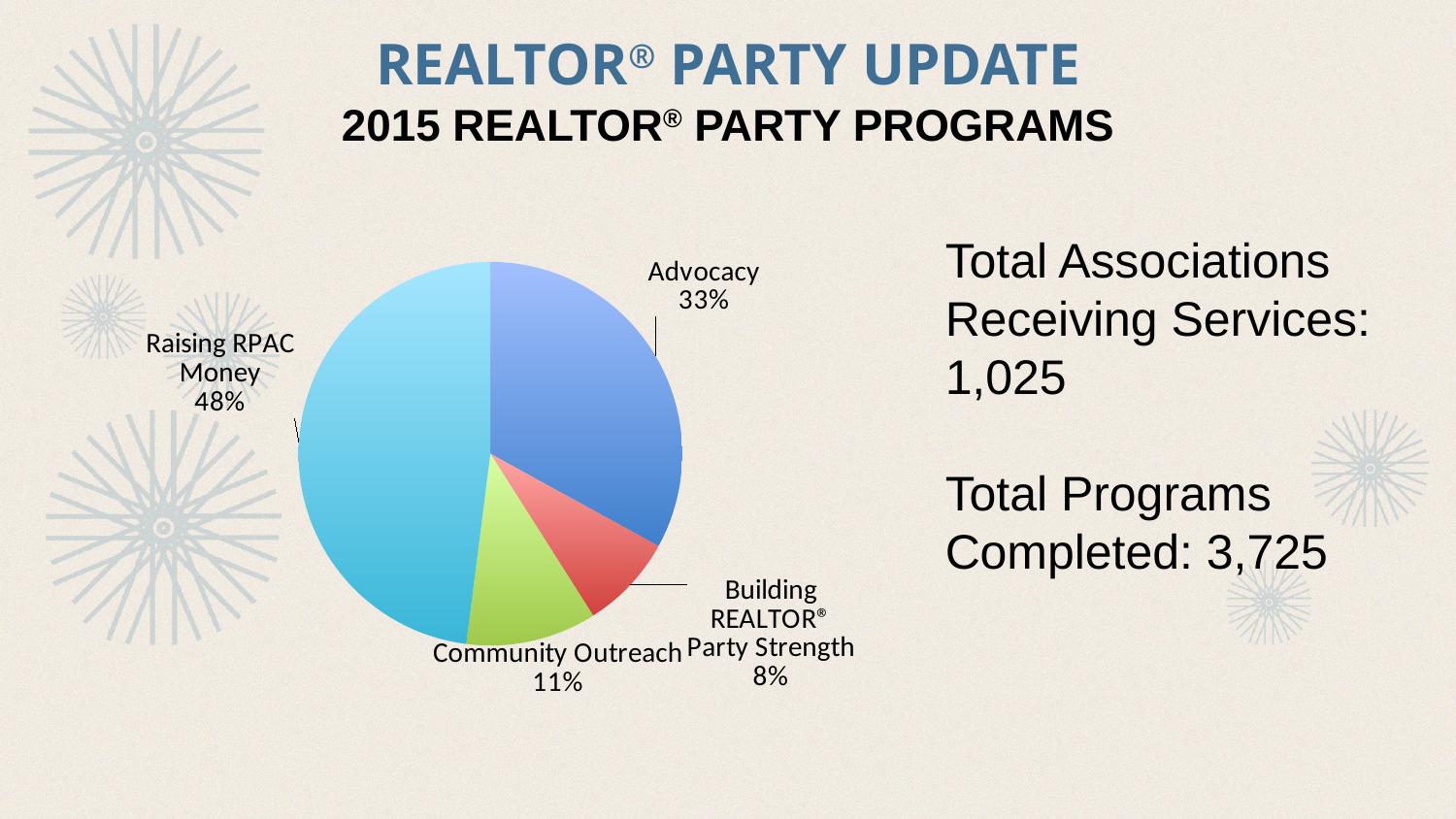
What share of the pie does Raising RPAC Money represent? 48% Which category has the largest slice of the pie? Raising RPAC Money How many categories are shown in the pie chart? 4 What is the value shown for Building REALTOR® Party Strength? 8% Which is larger, Community Outreach or Building REALTOR® Party Strength? Community Outreach What share of the pie does Advocacy represent? 33% Which category has the smallest slice of the pie? Building REALTOR® Party Strength What colour is the Raising RPAC Money slice? light blue What is the value shown for Community Outreach? 11% What kind of chart is shown on the slide? pie chart What is the difference in percentage points between Advocacy and Community Outreach? 22 What is the difference in percentage points between Raising RPAC Money and Advocacy? 15